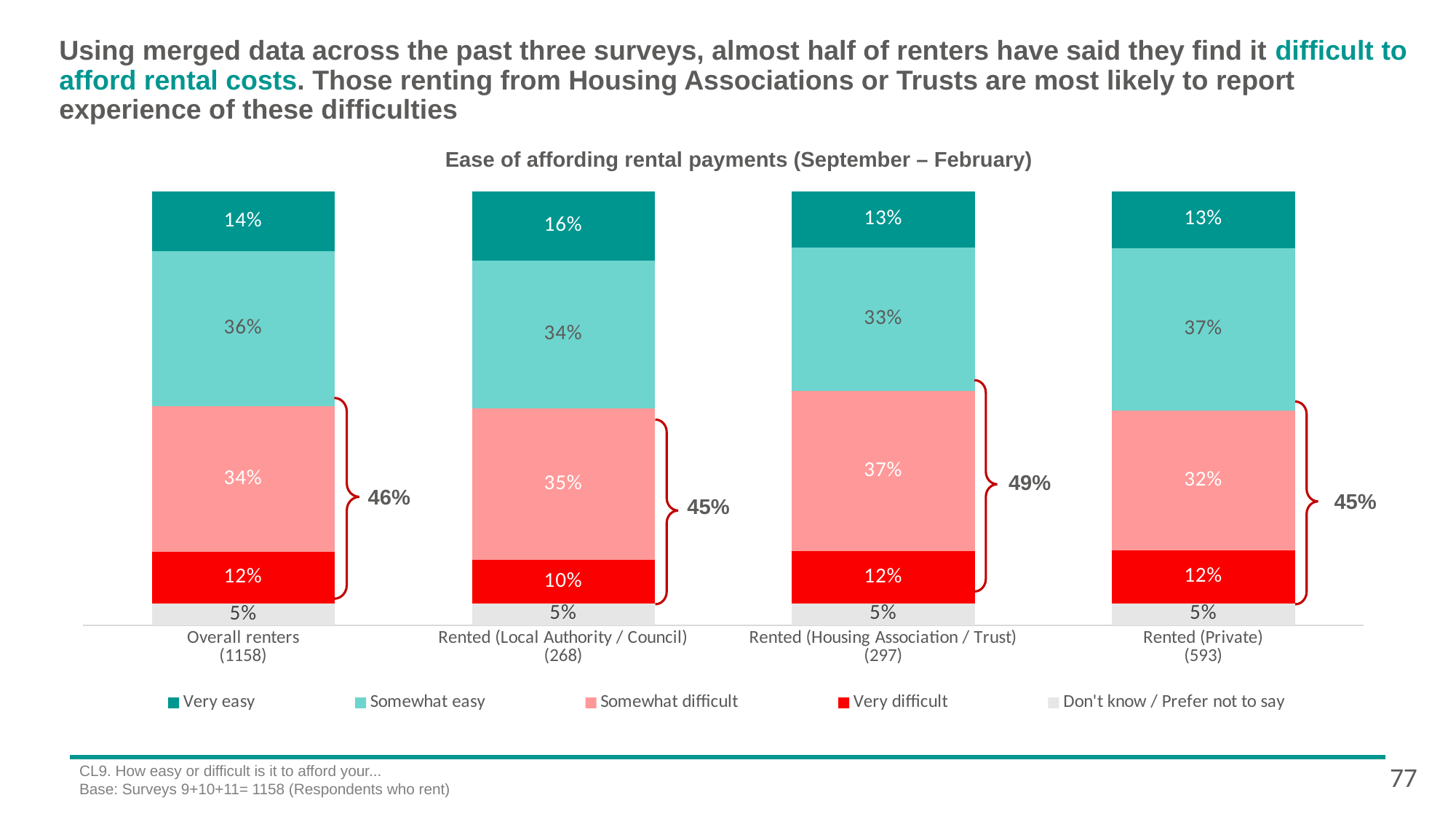
How many categories are shown on the x axis? 4 What is the combined 'Somewhat difficult' and 'Very difficult' share shown by the bracket for Rented (Housing Association / Trust)? 49% What is the 'Somewhat easy' value for Rented (Private)? 37% What is the difference between the 'Somewhat easy' values for Rented (Private) and Rented (Housing Association / Trust)? 4% What is the 'Very easy' value for Rented (Local Authority / Council)? 16% Which category has the lowest 'Very difficult' value? Rented (Local Authority / Council) What kind of chart is shown? Stacked bar chart How many series does the legend list? 5 Which is larger: the 'Very easy' value for Rented (Local Authority / Council) or for Rented (Private)? Rented (Local Authority / Council) What is the 'Somewhat difficult' value for Rented (Housing Association / Trust)? 37% What is the 'Very difficult' value for Overall renters? 12% Which category has the highest 'Somewhat difficult' value? Rented (Housing Association / Trust)